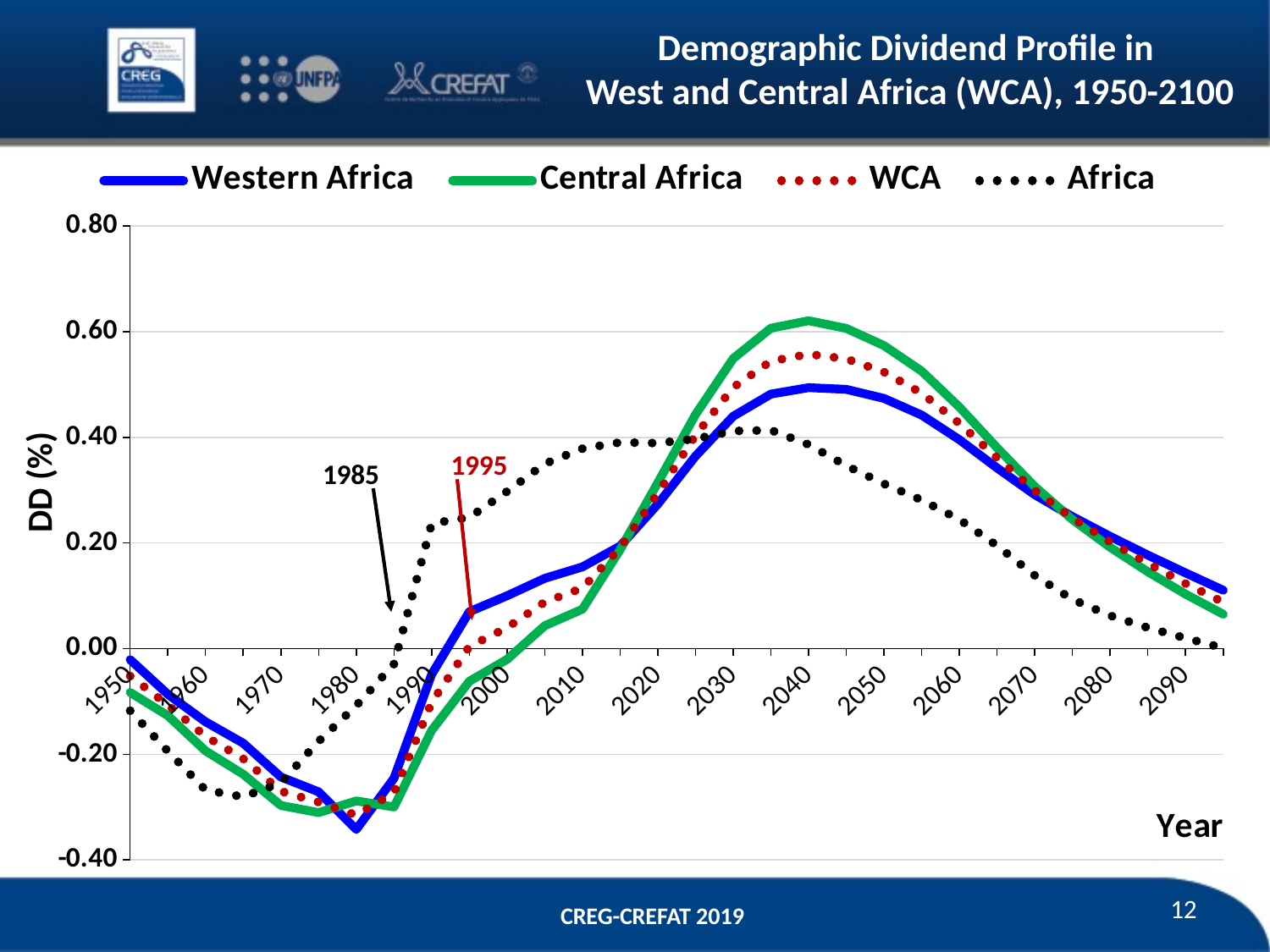
In which year does the WCA line cross zero, according to the annotation on the chart? 1995 What label is shown on the vertical axis? DD (%) What is the title of the chart? Demographic Dividend Profile in West and Central Africa (WCA), 1950-2100 Is the peak value of the Western Africa line greater or less than 0.40? greater Is the peak value of the Western Africa line greater or less than 0.60? less How many series does the legend list? 4 Does the Western Africa line rise or fall between 1950 and 1980? Fall What kind of chart is shown on the slide? Line chart In which year does the Africa line cross zero, according to the annotation on the chart? 1985 Is the lowest value of the Africa line greater or less than -0.20? less Which series reaches the highest peak value? Central Africa Around 2020, which is higher: the Africa line or the Western Africa line? Africa